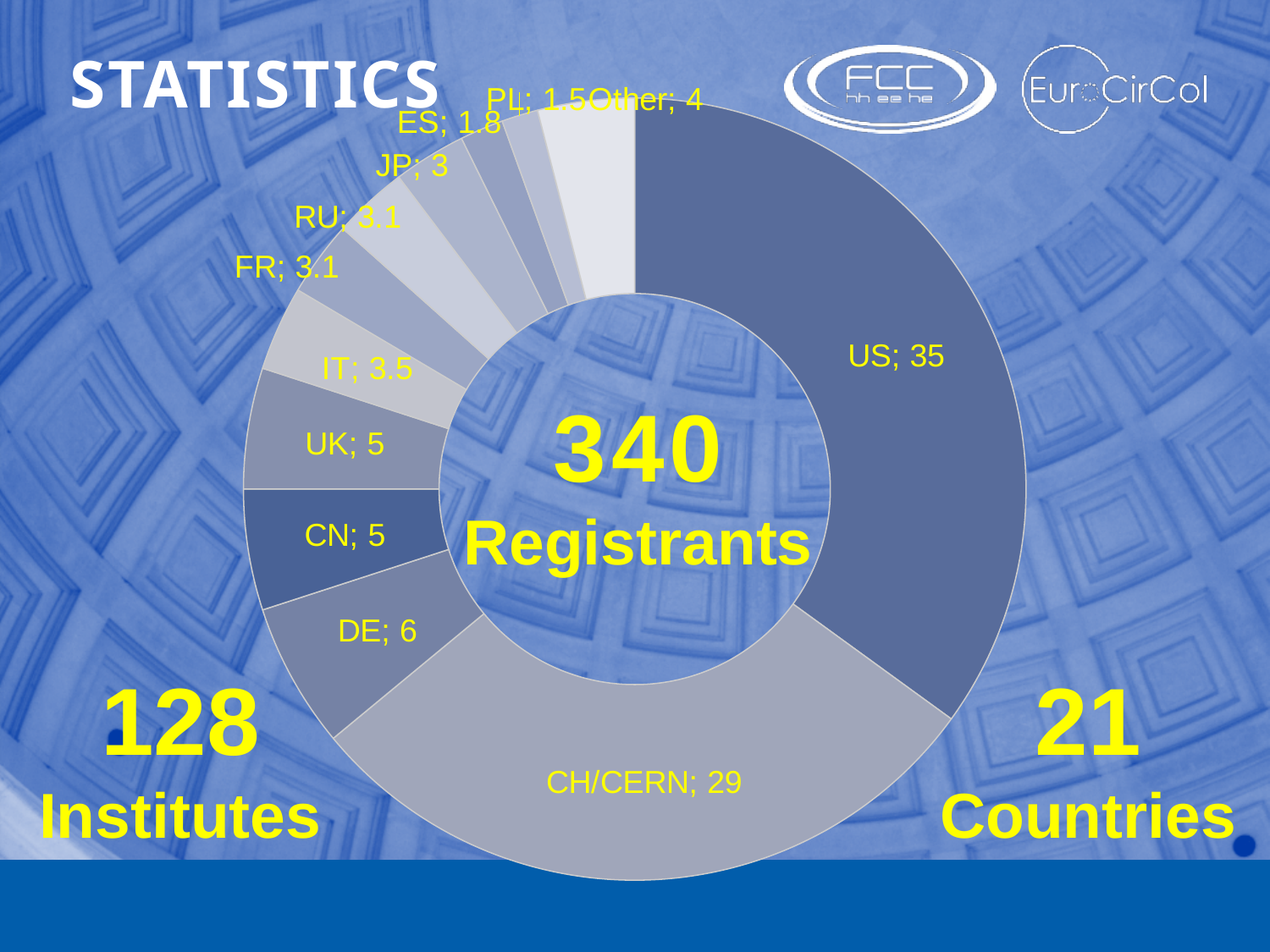
What value is shown for CH/CERN in the doughnut chart? 29 Which is larger, the value for DE or the value for UK? DE Which category has the largest slice in the doughnut chart? US What value is shown for ES in the doughnut chart? 1.8 What text is shown in the centre of the doughnut chart? 340 Registrants What value is shown for US in the doughnut chart? 35 How many slices does the doughnut chart have? 12 What value is shown for IT in the doughnut chart? 3.5 What value is shown for DE in the doughnut chart? 6 Which category has the smallest slice in the doughnut chart? PL What is the difference between the values for US and CH/CERN? 6 What kind of chart is shown on the slide? Doughnut (pie) chart